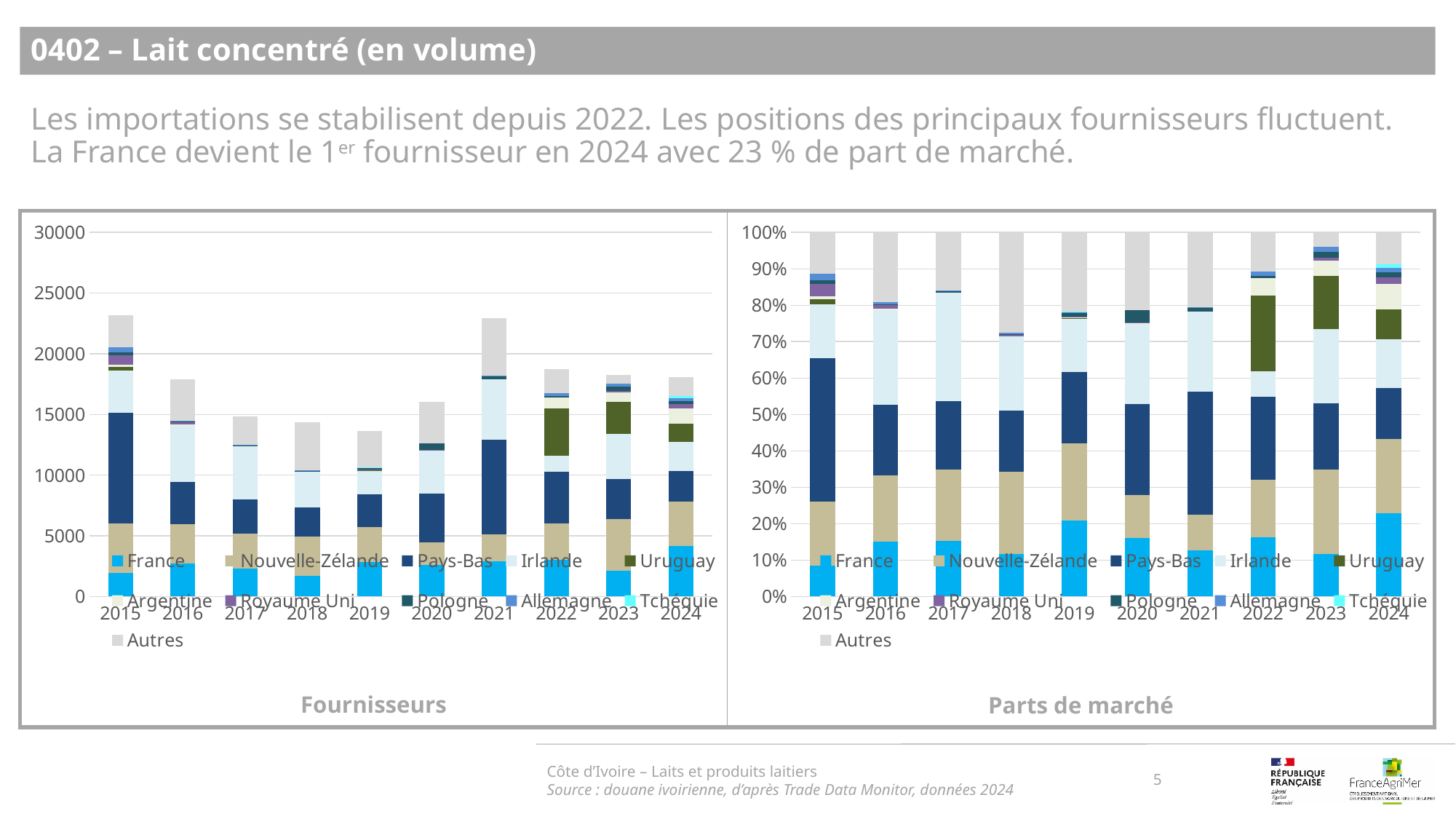
In the 'Parts de marché' chart, is the France share in 2024 greater or less than 20%? greater How many years are shown on the x axis of the 'Parts de marché' chart? 10 In the 'Parts de marché' chart, is the Uruguay share larger in 2022 or in 2023? 2022 In the 'Parts de marché' chart, is the Pays-Bas share in 2015 greater or less than 30%? greater In the 'Fournisseurs' chart, is the total bar for 2015 greater or less than 20000? greater How many series does the legend of the 'Fournisseurs' chart list? 11 What is the title shown under the right-hand chart? Parts de marché What kind of chart is the 'Fournisseurs' chart on the left? Stacked bar chart In the 'Parts de marché' chart, is the France share larger in 2015 or in 2024? 2024